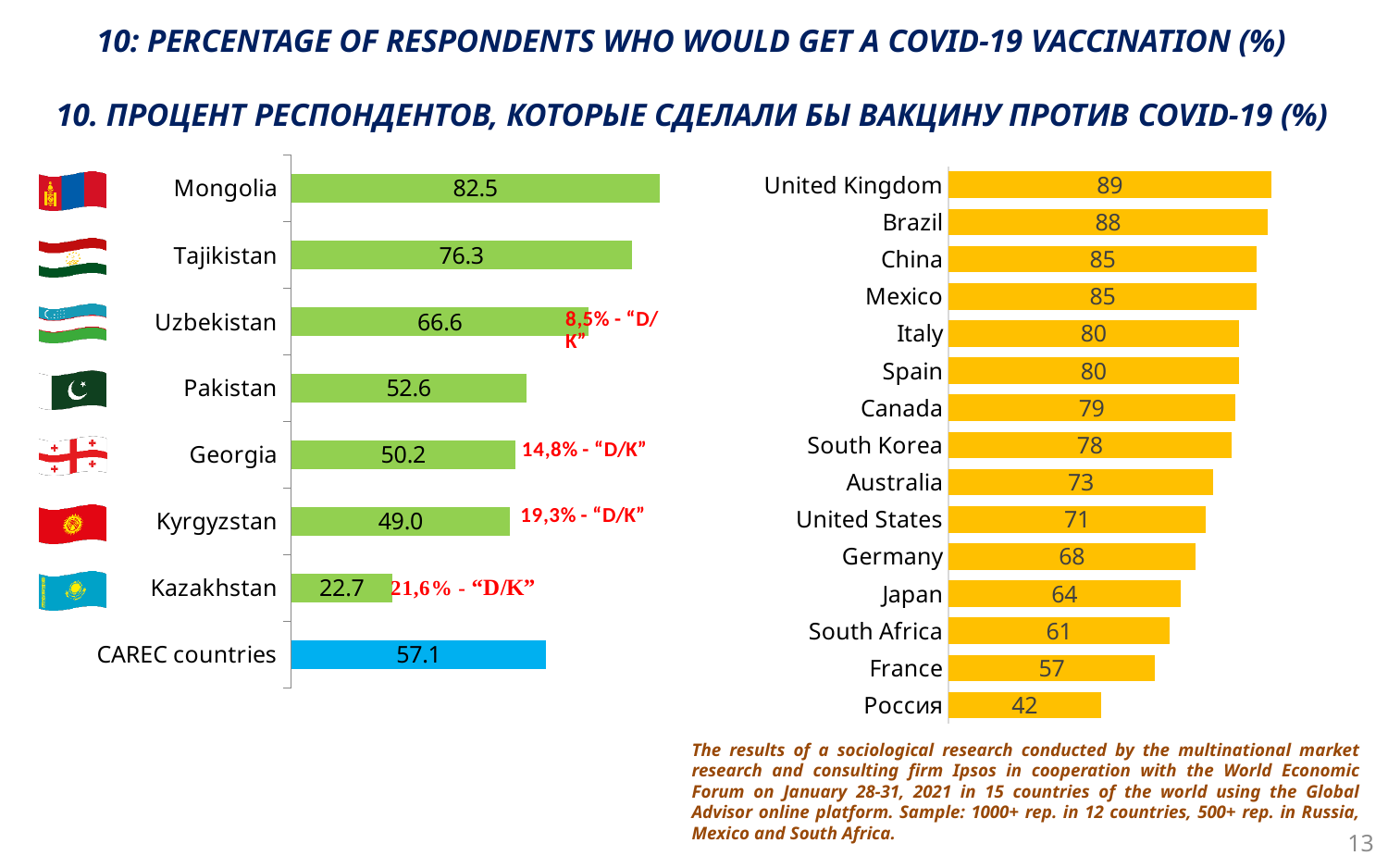
In the left chart, what is the value for CAREC countries? 57.1 In the right chart, which country has the highest value? United Kingdom In the right chart, what is the difference between Brazil and France? 31 In the right chart, which country has the lowest value? Россия In the left chart, which is larger, Pakistan or Georgia? Pakistan In the left chart, which country has the lowest value? Kazakhstan What type of chart is the right chart? Bar chart In the left chart, what is the value for Mongolia? 82.5 In the right chart, how many countries are plotted? 15 In the left chart, how many bars are plotted? 8 In the left chart, what is the difference between Mongolia and Tajikistan? 6.2 In the right chart, what is the value for Japan? 64